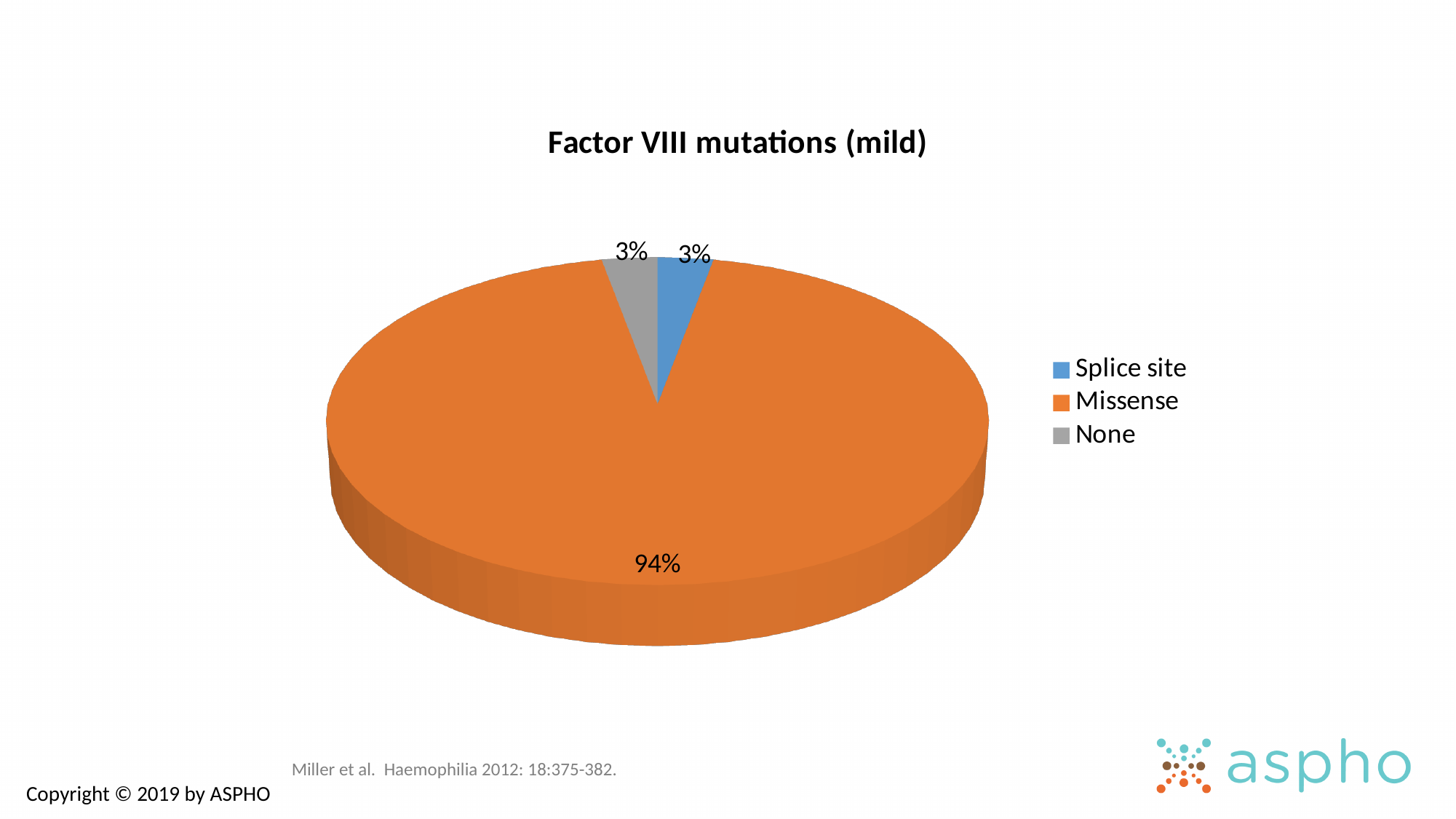
Which is larger, the share for Missense or the share for None? Missense What percentage of the pie is Splice site? 3% What percentage of the pie is Missense? 94% Which category has the largest share of the pie? Missense What percentage of the pie is None? 3% What type of chart is shown on the slide? Pie chart What is the title of the chart? Factor VIII mutations (mild) How many categories does the legend list? 3 Is the share for Missense greater or less than 50%? greater What is the difference in percentage points between Missense and Splice site? 91 What colour is the Missense slice? Orange